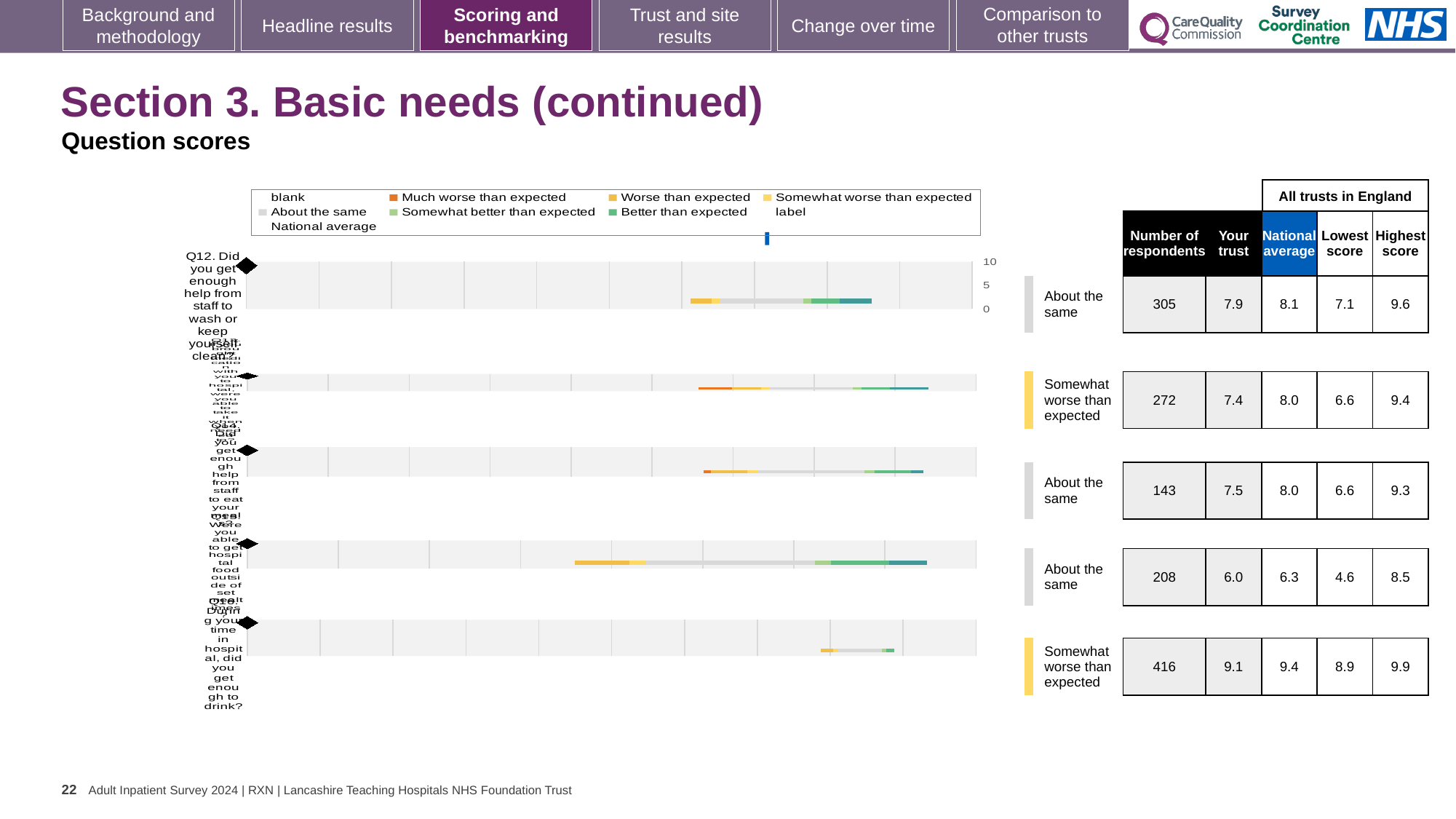
What is the largest number of respondents shown in the table? 416 What is the 'Your trust' score for Q12? 7.9 How many question rows are plotted in the chart? 5 What is the national average score for Q12? 8.1 Which is larger for Q12, the 'Your trust' score or the national average? National average What is the highest score among all trusts in England for Q12? 9.6 What benchmark category is given for Q12? About the same How many of the five question rows are rated 'Somewhat worse than expected'? 2 What is the lowest 'Your trust' score shown in the table? 6.0 How many respondents are listed for Q12 (help from staff to wash or keep yourself clean)? 305 What kind of chart is shown on the slide? bar chart What is the difference between the national average and the 'Your trust' score for Q12? 0.2